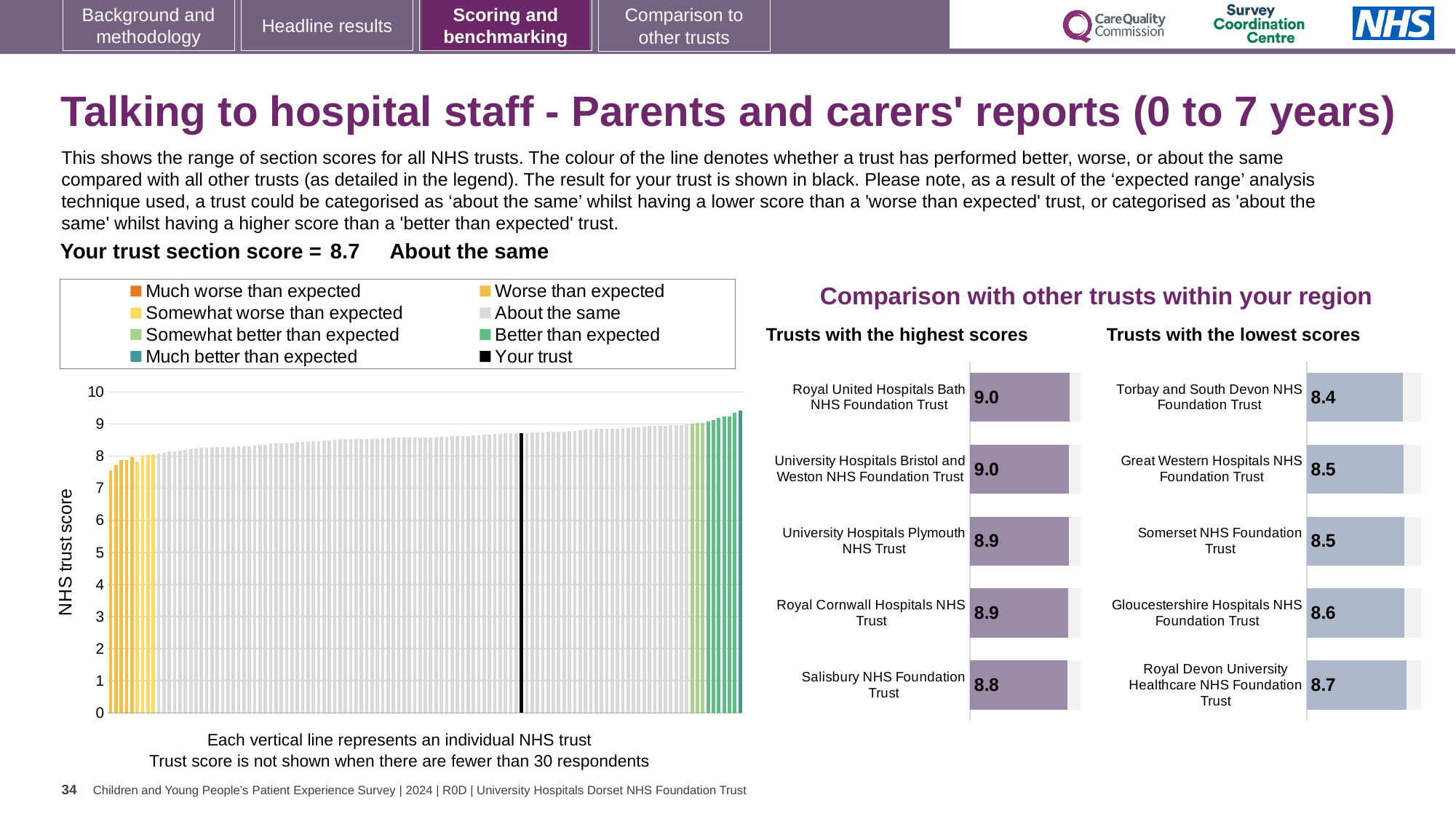
In the 'Trusts with the lowest scores' chart, which has the larger score: Great Western Hospitals NHS Foundation Trust or Gloucestershire Hospitals NHS Foundation Trust? Gloucestershire Hospitals NHS Foundation Trust In the 'Trusts with the highest scores' chart, what is the difference between the scores of Royal United Hospitals Bath NHS Foundation Trust and Salisbury NHS Foundation Trust? 0.2 In the 'Trusts with the highest scores' chart, which trust has the lowest score? Salisbury NHS Foundation Trust In the main chart on the left, is the value for the leftmost bar greater or less than 8? less How many entries does the legend of the main chart on the left list? 8 In the 'Trusts with the lowest scores' chart, which trust has the highest score? Royal Devon University Healthcare NHS Foundation Trust In the 'Trusts with the highest scores' chart, what is the score for Royal United Hospitals Bath NHS Foundation Trust? 9.0 In the 'Trusts with the lowest scores' chart, what is the score for Torbay and South Devon NHS Foundation Trust? 8.4 How many trusts are listed in the 'Trusts with the lowest scores' chart? 5 In the main chart on the left, do the bar values rise or fall from left to right? rise In the 'Trusts with the lowest scores' chart, which trust has the lowest score? Torbay and South Devon NHS Foundation Trust In the 'Trusts with the highest scores' chart, what is the score for Salisbury NHS Foundation Trust? 8.8